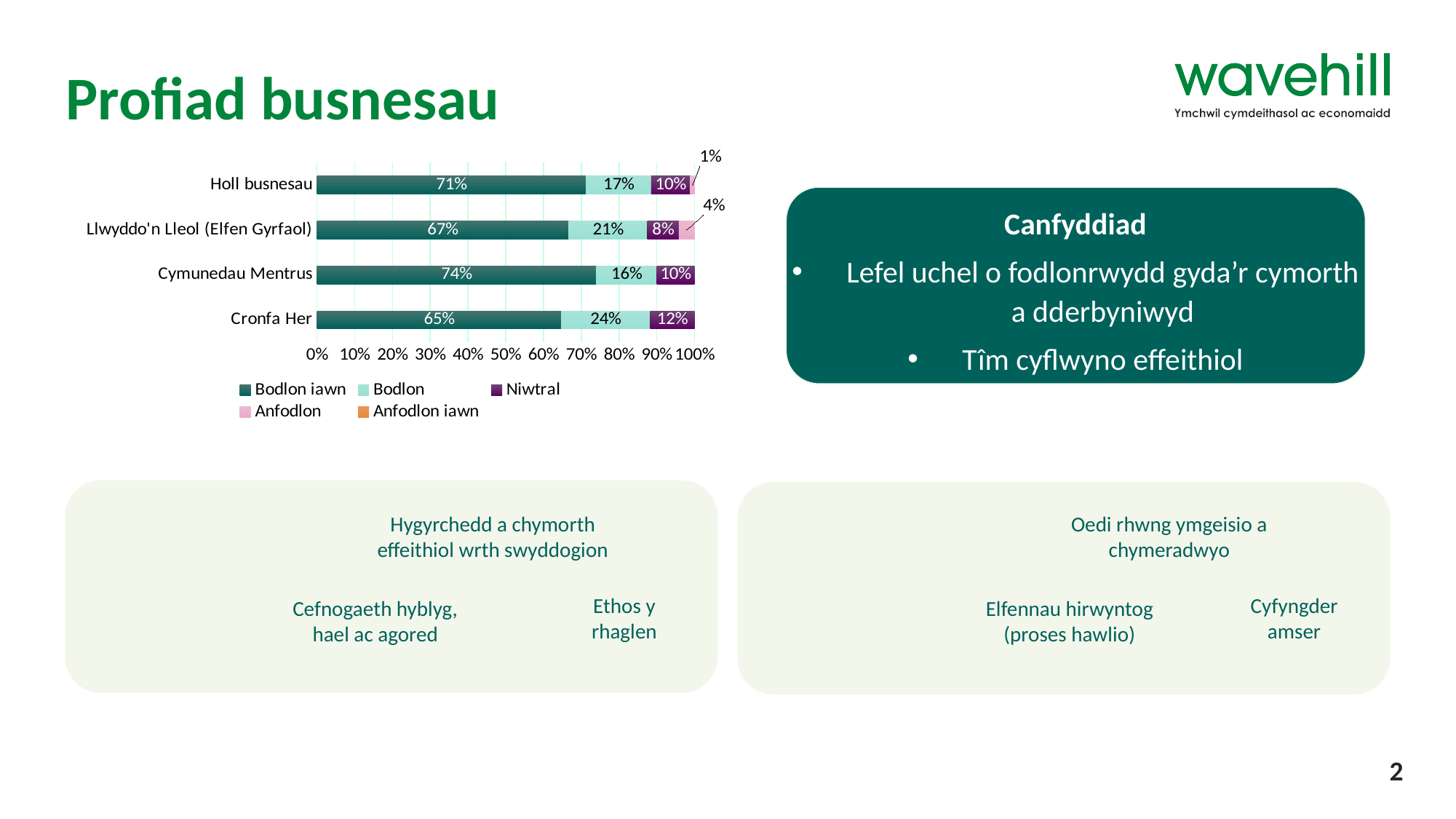
Which category has the highest Bodlon iawn value? Cymunedau Mentrus What kind of chart is shown on the slide? Stacked bar chart What is the difference between the Bodlon iawn values for Cymunedau Mentrus and Cronfa Her? 9% What is the Bodlon value for Cronfa Her? 24% Which series is shown in the darkest green colour in the legend? Bodlon iawn Which has the larger Bodlon value, Llwyddo'n Lleol (Elfen Gyrfaol) or Holl busnesau? Llwyddo'n Lleol (Elfen Gyrfaol) What is the Bodlon iawn value for Cymunedau Mentrus? 74% How many categories are plotted on the chart? 4 How many series does the chart legend list? 5 What is the Niwtral value for Llwyddo'n Lleol (Elfen Gyrfaol)? 8% What is the Anfodlon value for Holl busnesau? 1% Which category has the lowest Bodlon iawn value? Cronfa Her